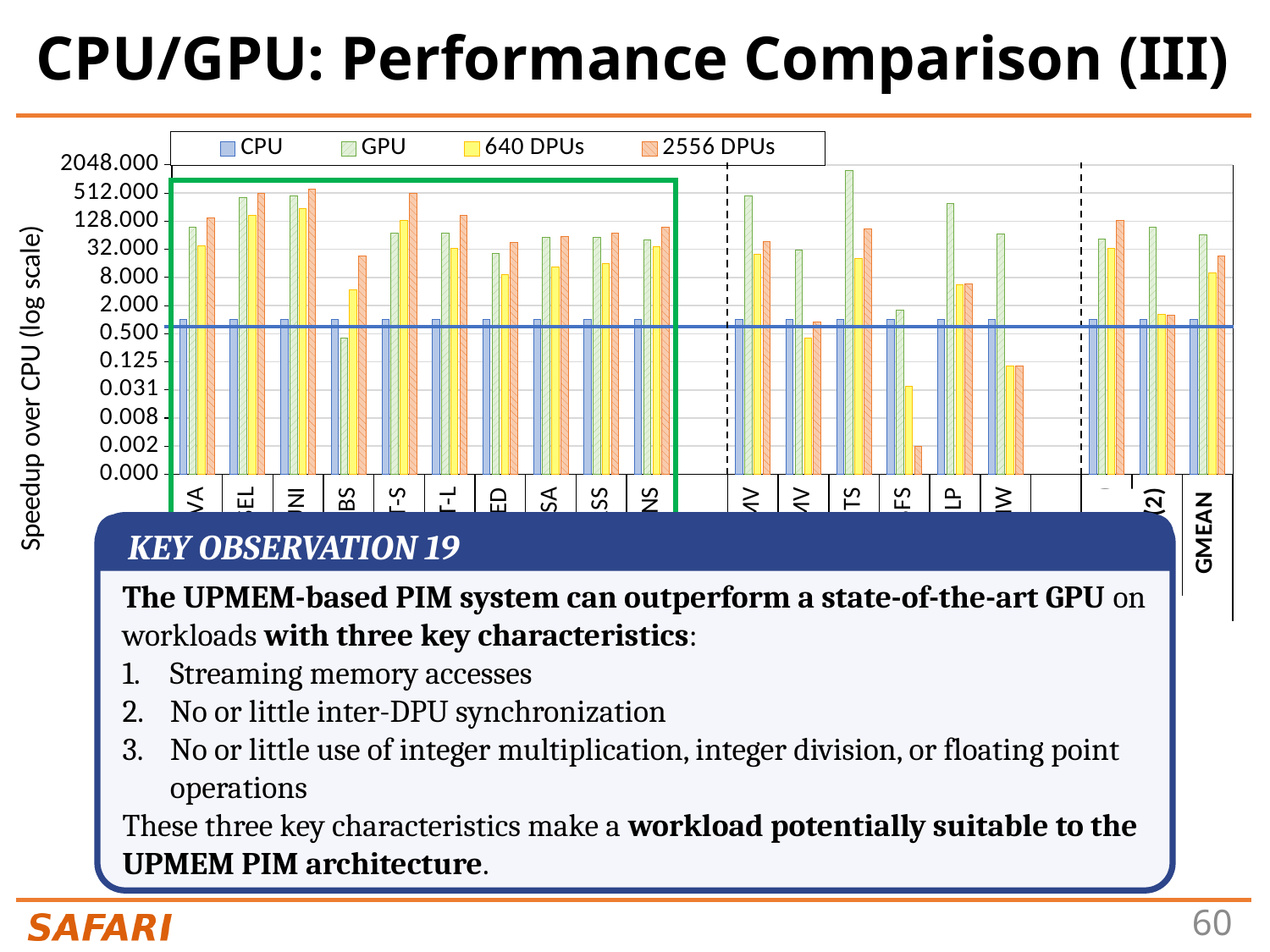
How many series does the chart legend list? 4 Is the 2556 DPUs value for SEL greater or less than 128.000? greater What are the four series listed in the chart legend? CPU, GPU, 640 DPUs, 2556 DPUs Is the GPU value for GMEAN greater or less than 32.000? greater For GMEAN, which is larger: the 640 DPUs value or the 2556 DPUs value? 2556 DPUs Is the 2556 DPUs value for BS greater or less than 8.000? greater What kind of chart is shown on the slide? bar chart For GMEAN, which is larger: the GPU value or the 2556 DPUs value? GPU What is the label of the chart's vertical axis? Speedup over CPU (log scale)